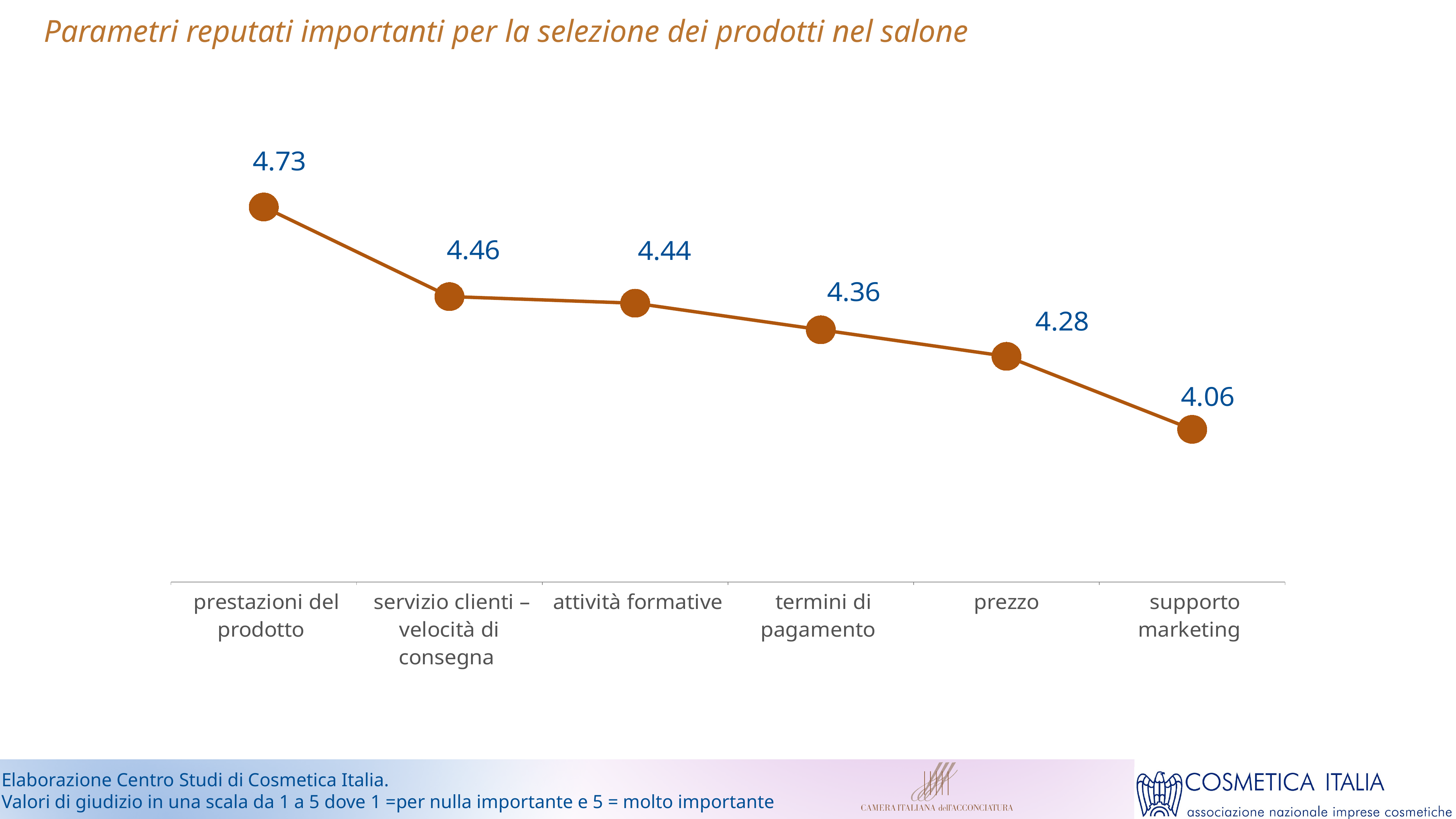
How many categories are plotted on the chart? 6 What is the value for prezzo? 4.28 What kind of chart is shown on the slide? line chart What is the value for prestazioni del prodotto? 4.73 Which category has the highest value? prestazioni del prodotto What is the value for termini di pagamento? 4.36 Which is larger, the value for attività formative or the value for termini di pagamento? attività formative What is the value for supporto marketing? 4.06 What is the difference between the values for prestazioni del prodotto and supporto marketing? 0.67 Which category has the lowest value? supporto marketing What is the difference between the values for servizio clienti – velocità di consegna and prezzo? 0.18 Do the values rise or fall from left to right along the x axis? fall